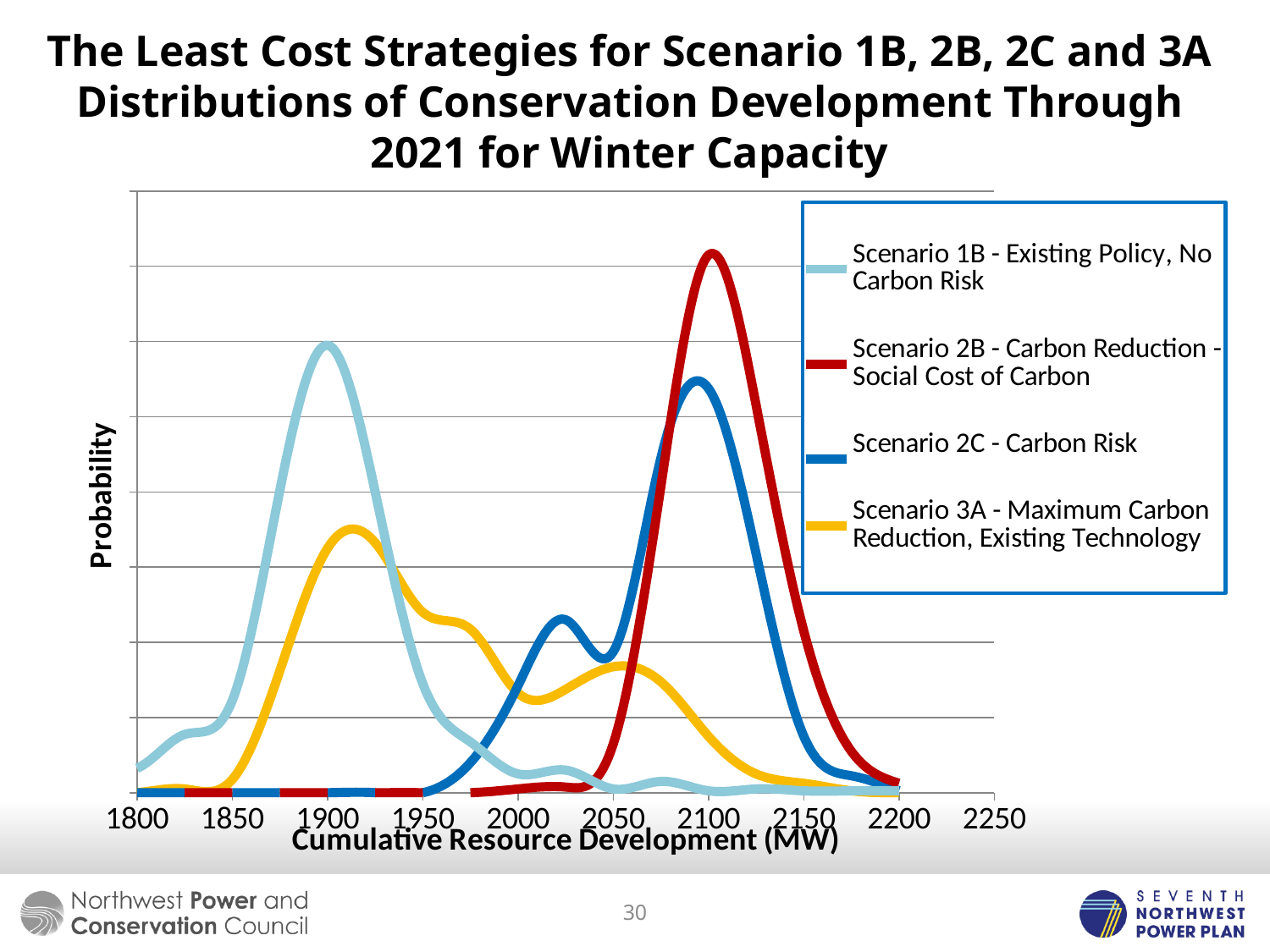
Which has a higher peak, Scenario 2B or Scenario 2C? Scenario 2B How many series does the legend list? 4 Which scenario has the highest peak probability? Scenario 2B - Carbon Reduction - Social Cost of Carbon Is the cumulative resource development at the peak of Scenario 1B greater or less than 1950 MW? less Which scenario is drawn with the red line? Scenario 2B - Carbon Reduction - Social Cost of Carbon How many labelled tick values are shown on the x axis? 10 Which scenario has the lowest peak probability? Scenario 3A - Maximum Carbon Reduction, Existing Technology What kind of chart is shown on the slide? line chart Is the cumulative resource development at the peak of Scenario 2B greater or less than 2050 MW? greater Which has a higher peak, Scenario 1B or Scenario 3A? Scenario 1B Does the Scenario 2B curve rise or fall between 2100 and 2200 MW on the x axis? fall What is the title of the x axis? Cumulative Resource Development (MW)